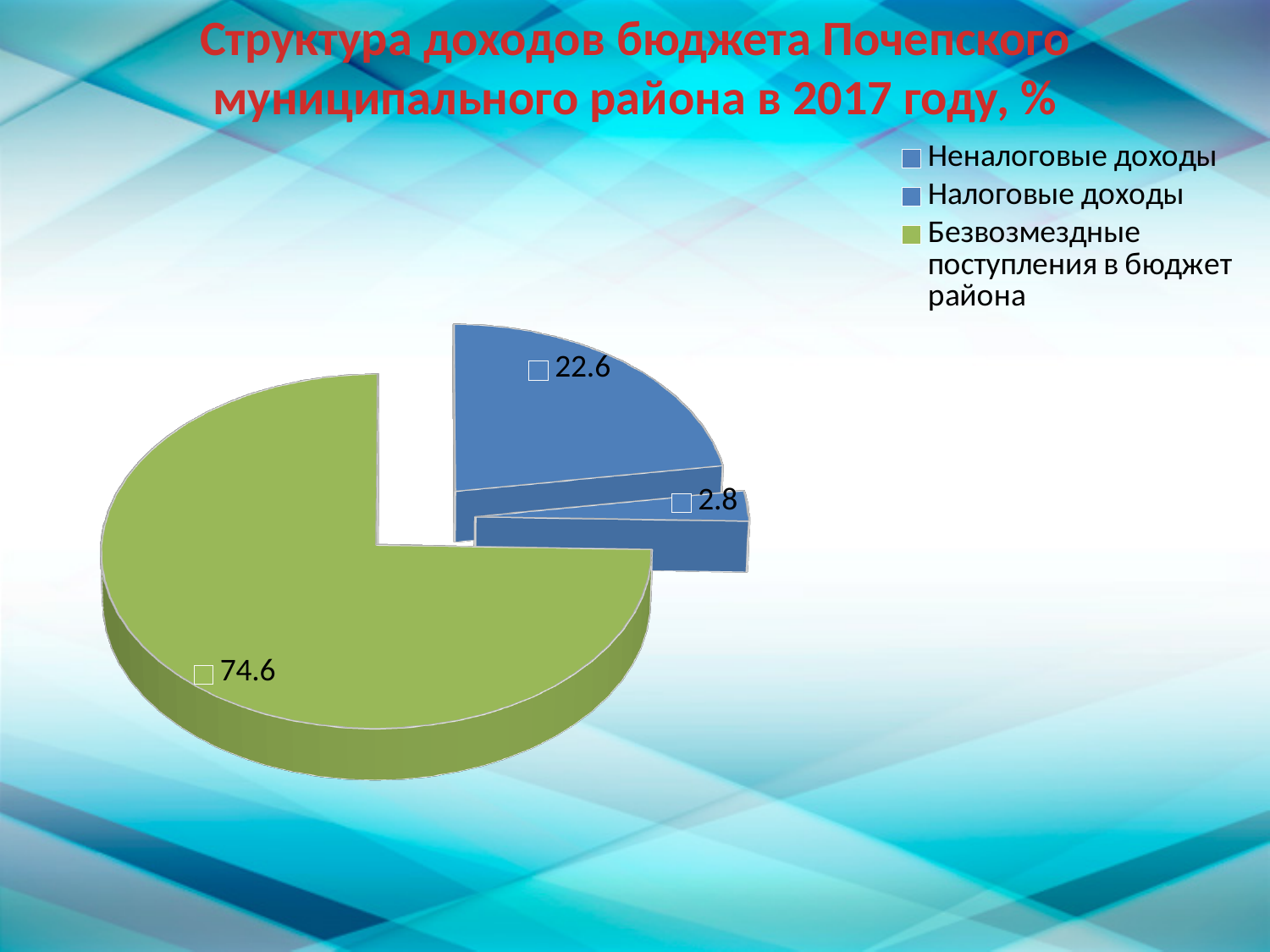
What is the difference between the slice labelled 22.6 and the slice labelled 2.8? 19.8 What colour is the slice for Безвозмездные поступления в бюджет района? green What is the difference between the largest slice (74.6) and the slice labelled 22.6? 52.0 Is the slice labelled 74.6 larger or smaller than the slice labelled 22.6? larger What is the smallest value labelled on the pie chart? 2.8 What year does the chart title refer to? 2017 What is the value of the slice for Безвозмездные поступления в бюджет района? 74.6 Which category has the largest slice of the pie? Безвозмездные поступления в бюджет района What is the largest value labelled on the pie chart? 74.6 How many entries does the legend list? 3 What kind of chart is shown on the slide? pie chart How many slices does the pie chart have? 3